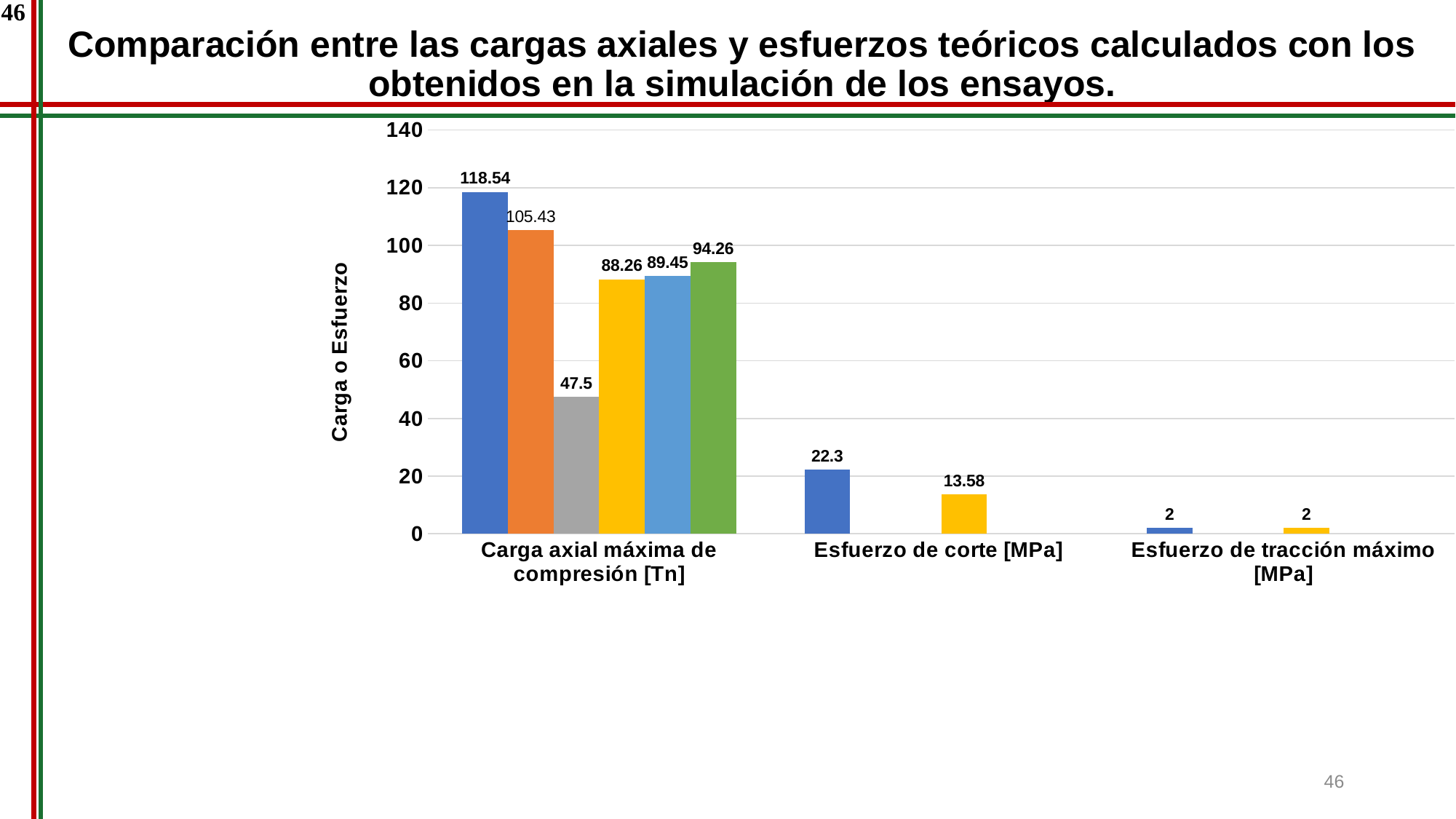
What is the value of the green bar in the 'Carga axial máxima de compresión [Tn]' category? 94.26 What is the value of the shortest bar in the 'Carga axial máxima de compresión [Tn]' category? 47.5 Which is larger in the 'Carga axial máxima de compresión [Tn]' category: the yellow bar or the green bar? the green bar What is the value of the orange bar in the 'Carga axial máxima de compresión [Tn]' category? 105.43 What is the difference between the blue bar (22.3) and the yellow bar (13.58) in the 'Esfuerzo de corte [MPa]' category? 8.72 What is the value of the blue bar in the 'Esfuerzo de corte [MPa]' category? 22.3 How many categories are shown on the x axis of the chart? 3 What is the value of the yellow bar in the 'Esfuerzo de corte [MPa]' category? 13.58 What is the difference between the tallest bar (118.54) and the shortest bar (47.5) in the 'Carga axial máxima de compresión [Tn]' category? 71.04 What is the value of the tallest bar in the 'Carga axial máxima de compresión [Tn]' category? 118.54 What is the y-axis title of the chart? Carga o Esfuerzo What kind of chart is shown on the slide? bar chart